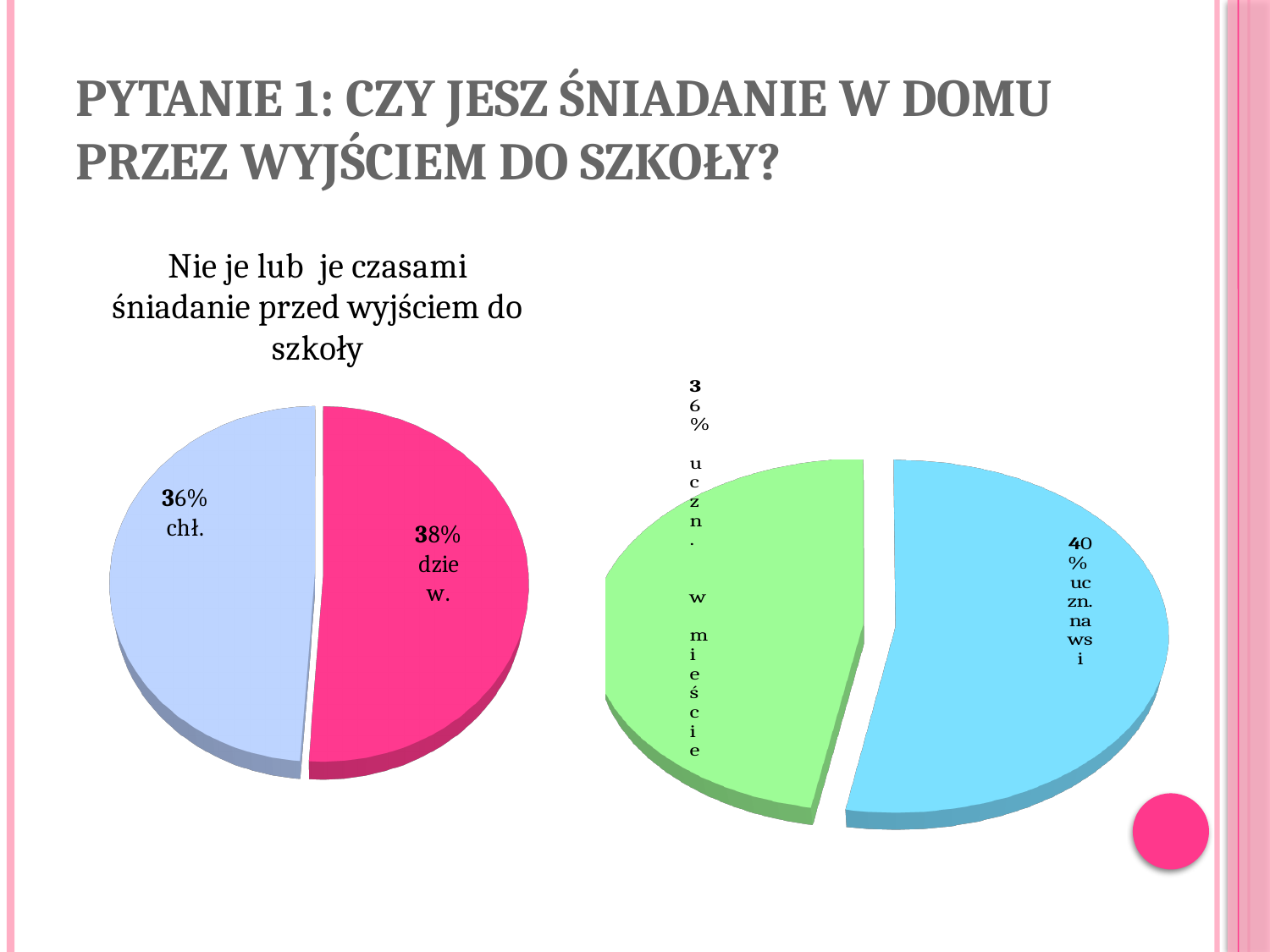
What type of chart is the chart on the left of the slide? Pie chart In the left pie chart titled "Nie je lub je czasami śniadanie przed wyjściem do szkoły", what percentage is shown for "dziew."? 38% In the right pie chart, what is the difference in percentage points between "uczn. na wsi" and "uczn. w mieście"? 4 percentage points How many slices does the left pie chart have? 2 In the right pie chart, what percentage is shown for "uczn. w mieście"? 36% In the right pie chart, which group has the higher percentage, "uczn. w mieście" or "uczn. na wsi"? uczn. na wsi How many slices does the right pie chart have? 2 In the right pie chart, what colour is the slice for "uczn. na wsi"? Light blue In the left pie chart, what is the difference in percentage points between "dziew." and "chł."? 2 percentage points In the left pie chart titled "Nie je lub je czasami śniadanie przed wyjściem do szkoły", what percentage is shown for "chł."? 36% In the left pie chart, which group has the higher percentage, "chł." or "dziew."? dziew. In the right pie chart, what percentage is shown for "uczn. na wsi"? 40%